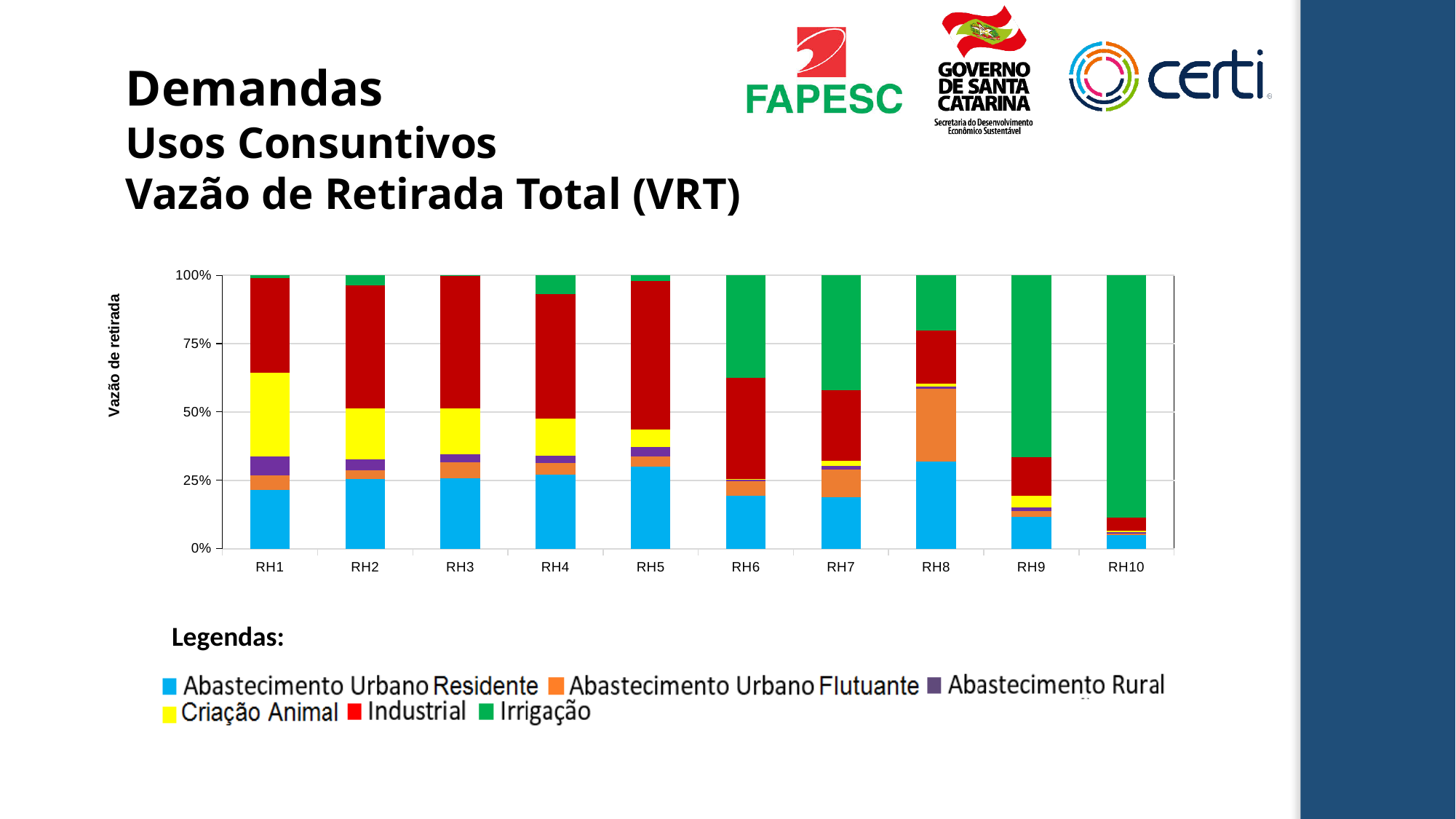
How many series does the legend list? 6 Is the Irrigação share for RH10 greater or less than 75%? greater Is the Abastecimento Urbano Residente share for RH8 greater or less than 25%? greater Is the Abastecimento Urbano Residente share for RH1 greater or less than 25%? less Which category has the smallest Abastecimento Urbano Residente share? RH10 Which has the larger Irrigação share, RH9 or RH1? RH9 What kind of chart is shown on the slide? Stacked bar chart How many categories (RH regions) are shown on the x axis? 10 Which category has the largest Irrigação share? RH10 Which category has the largest Abastecimento Urbano Flutuante share? RH8 What is the label of the y axis? Vazão de retirada